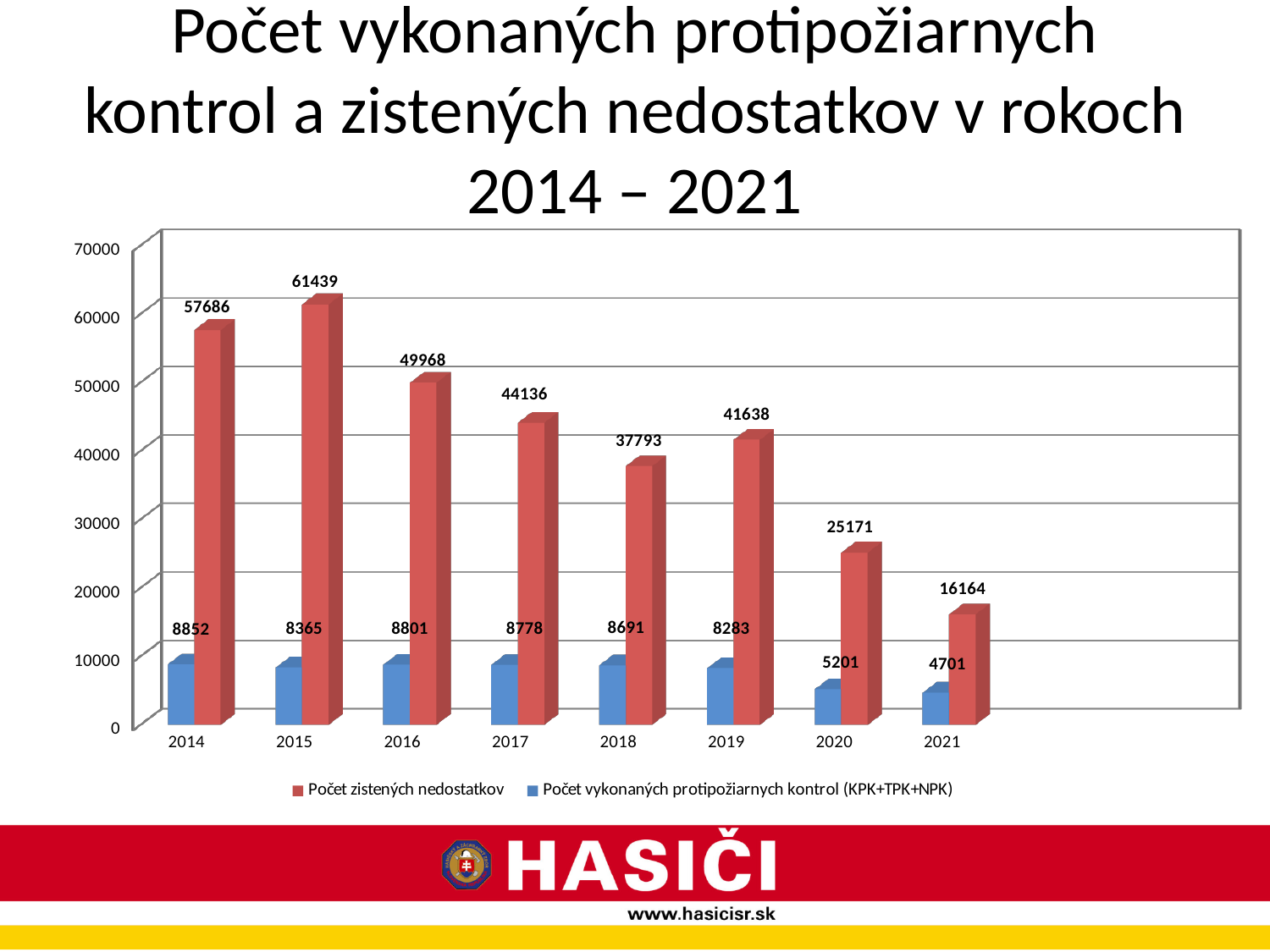
What is the value of Počet vykonaných protipožiarnych kontrol (KPK+TPK+NPK) for 2021? 4701 What kind of chart is shown on the slide? bar chart What is the difference between Počet zistených nedostatkov in 2014 and in 2015? 3753 How many series does the legend list? 2 How many years are shown on the x axis? 8 Which year has the highest value of Počet zistených nedostatkov? 2015 Which is larger: Počet zistených nedostatkov in 2018 or in 2019? 2019 What is the value of Počet zistených nedostatkov for 2015? 61439 Which year has the lowest value of Počet vykonaných protipožiarnych kontrol (KPK+TPK+NPK)? 2021 What is the value of Počet zistených nedostatkov for 2020? 25171 Which colour represents Počet zistených nedostatkov in the chart? red Is the value of Počet zistených nedostatkov for 2017 greater or less than 40000? greater